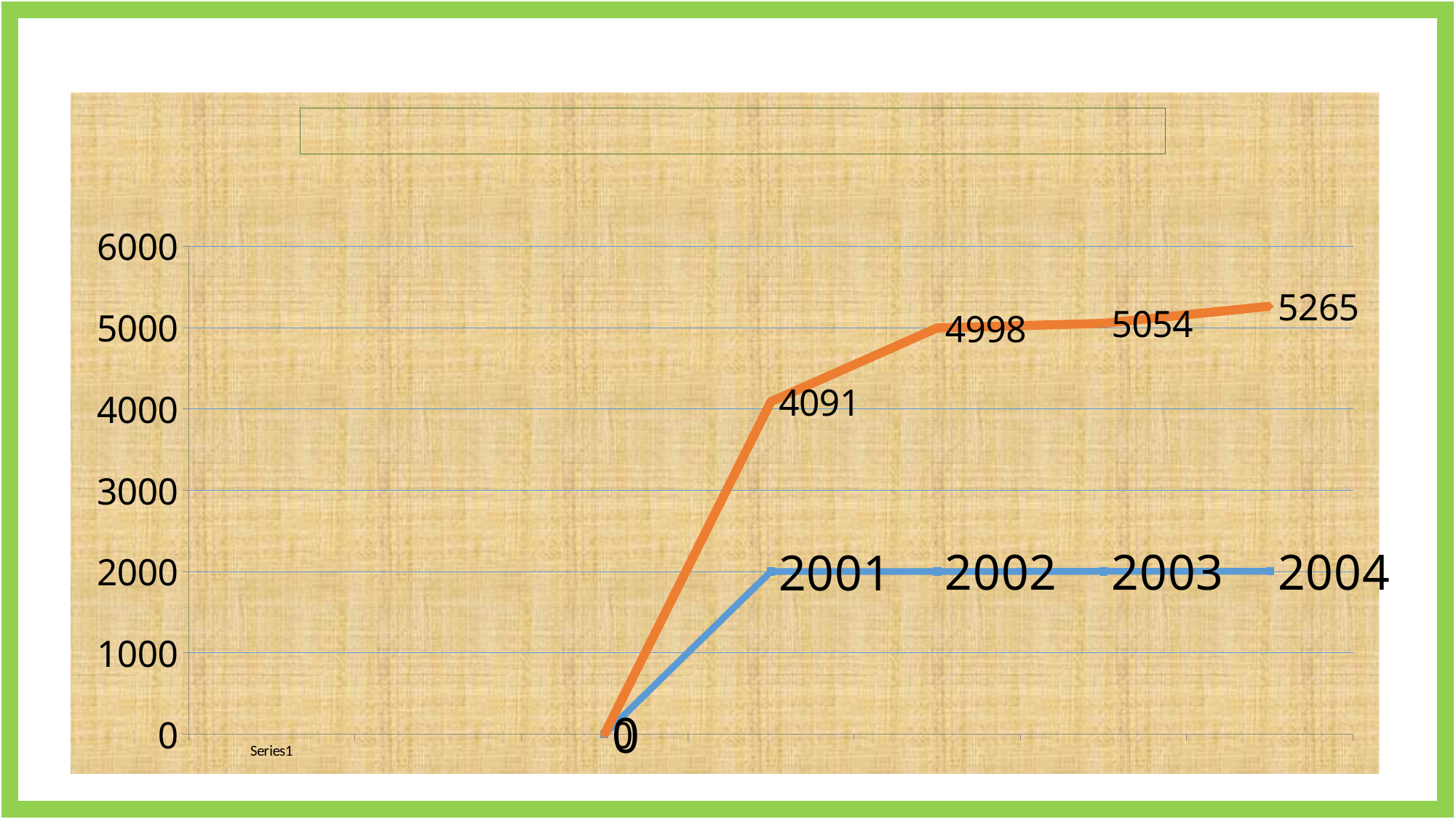
What is the difference between the orange line's last value (5265) and its previous value (5054)? 211 What is the orange line's value at the point where the blue line is labelled 2001? 4091 What type of chart is shown on the slide? line chart At the last point on the right, which line is higher, the orange line or the blue line? orange line What is the orange line's value at the point where the blue line is labelled 2002? 4998 What is the highest value labelled on the orange line? 5265 How many data points does the orange line have? 5 What is the value labelled at the first point of the orange line? 0 What label is printed on the x axis at the left of the chart? Series1 Does the orange line rise or fall from left to right? rises What is the orange line's value at the point where the blue line is labelled 2003? 5054 How many lines are plotted on the chart? 2